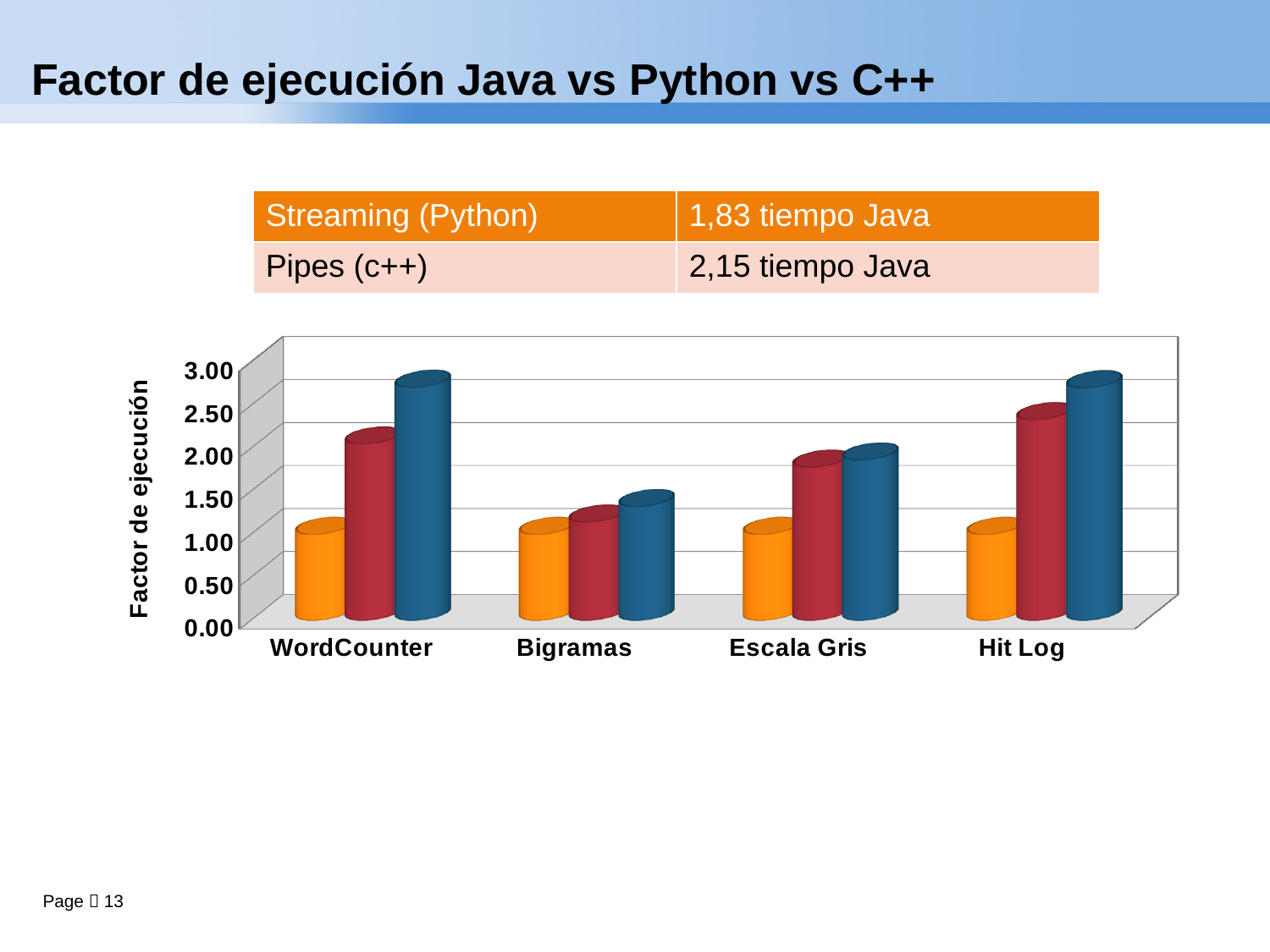
What is the title of the vertical axis of the chart? Factor de ejecución Is the value of the red bar for Escala Gris greater or less than 1.50? greater Is the value of the red bar for Bigramas greater or less than 1.50? less Which is larger, the blue bar for WordCounter or the blue bar for Bigramas? WordCounter Is the value of the blue bar for Hit Log greater or less than 2.50? greater What kind of chart is shown on the slide? bar chart How many categories are shown on the x axis of the chart? 4 How many bars are plotted for each category in the chart? 3 What is the highest value shown on the vertical axis of the chart? 3.00 Which category has the lowest bars overall in the chart? Bigramas